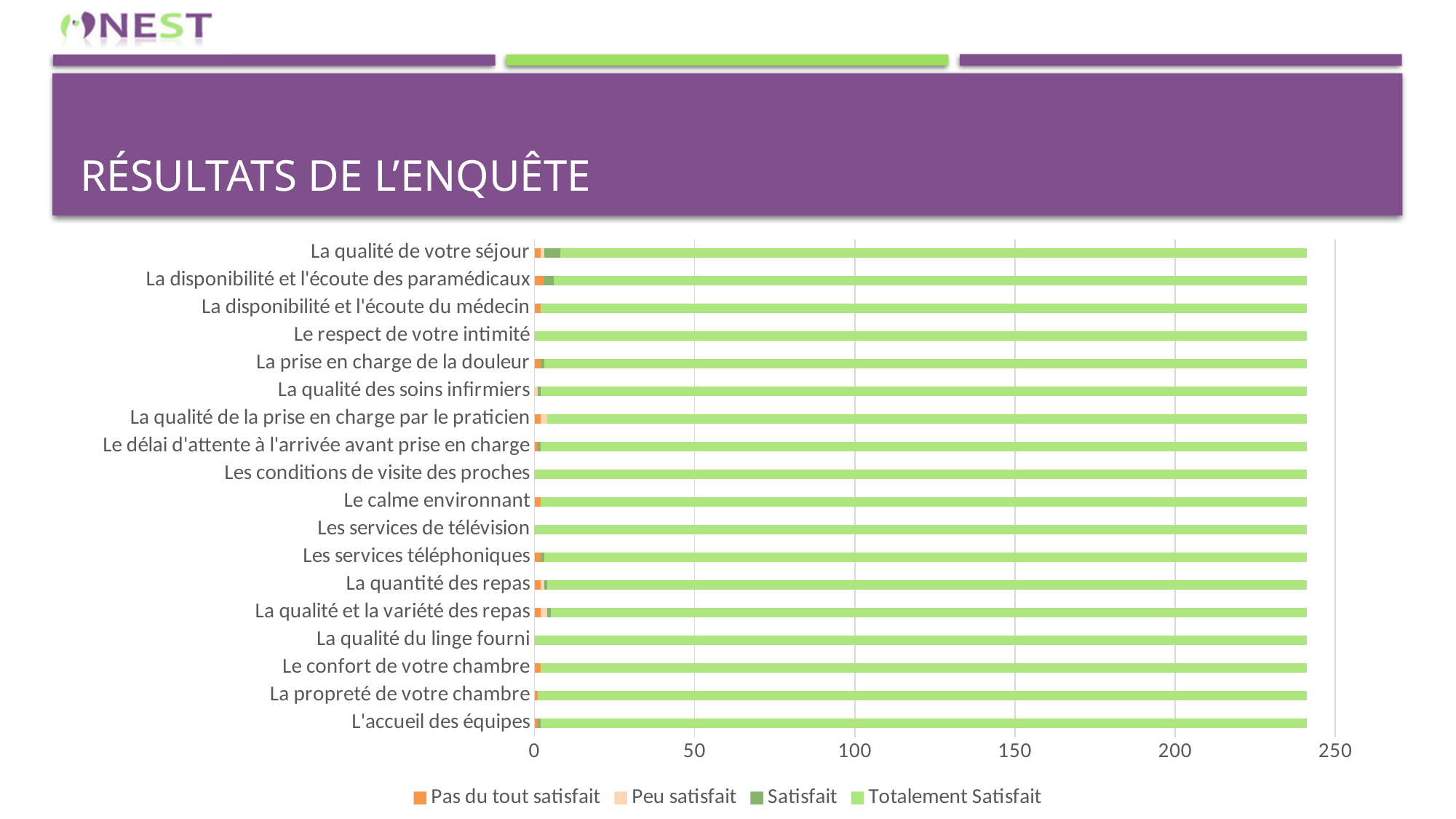
Is the total bar length for 'L'accueil des équipes' greater or less than 250? less What is the highest value shown on the horizontal axis? 250 Which category has the largest 'Satisfait' segment? La qualité de votre séjour What is the title of the slide containing the chart? RÉSULTATS DE L'ENQUÊTE How many categories are listed on the vertical axis of the chart? 18 Is the total bar length for 'La qualité de votre séjour' greater or less than 200? greater Is the total bar length for 'Les services de télévision' greater or less than 250? less How many series does the chart legend list? 4 Which legend entry is shown in light green? Totalement Satisfait What kind of chart is shown on the slide? Stacked bar chart